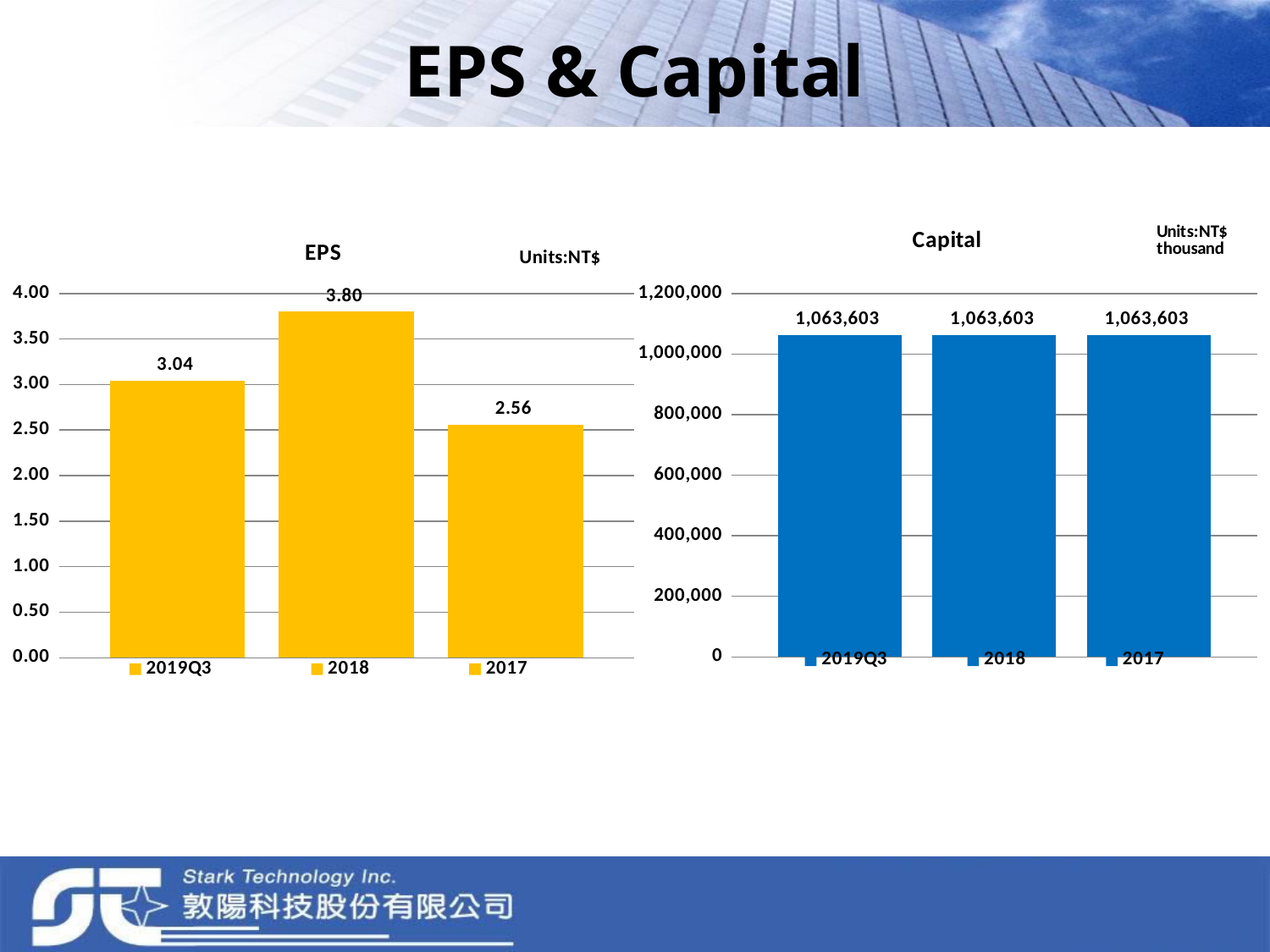
In the Capital chart, is the value for 2018 greater or less than 1,000,000? greater In the EPS chart, what is the value for 2018? 3.80 In the EPS chart, what is the difference between the 2018 and 2017 values? 1.24 In the EPS chart, which period has the lowest EPS? 2017 In the EPS chart, what is the value for 2019Q3? 3.04 What units are stated for the Capital chart? NT$ thousand In the Capital chart, what is the value for 2019Q3? 1,063,603 What kind of chart is the EPS chart? bar chart How many bars are shown in the Capital chart? 3 In the EPS chart, which period has the highest EPS? 2018 In the EPS chart, which is larger, the value for 2019Q3 or the value for 2017? 2019Q3 In the EPS chart, what is the value for 2017? 2.56